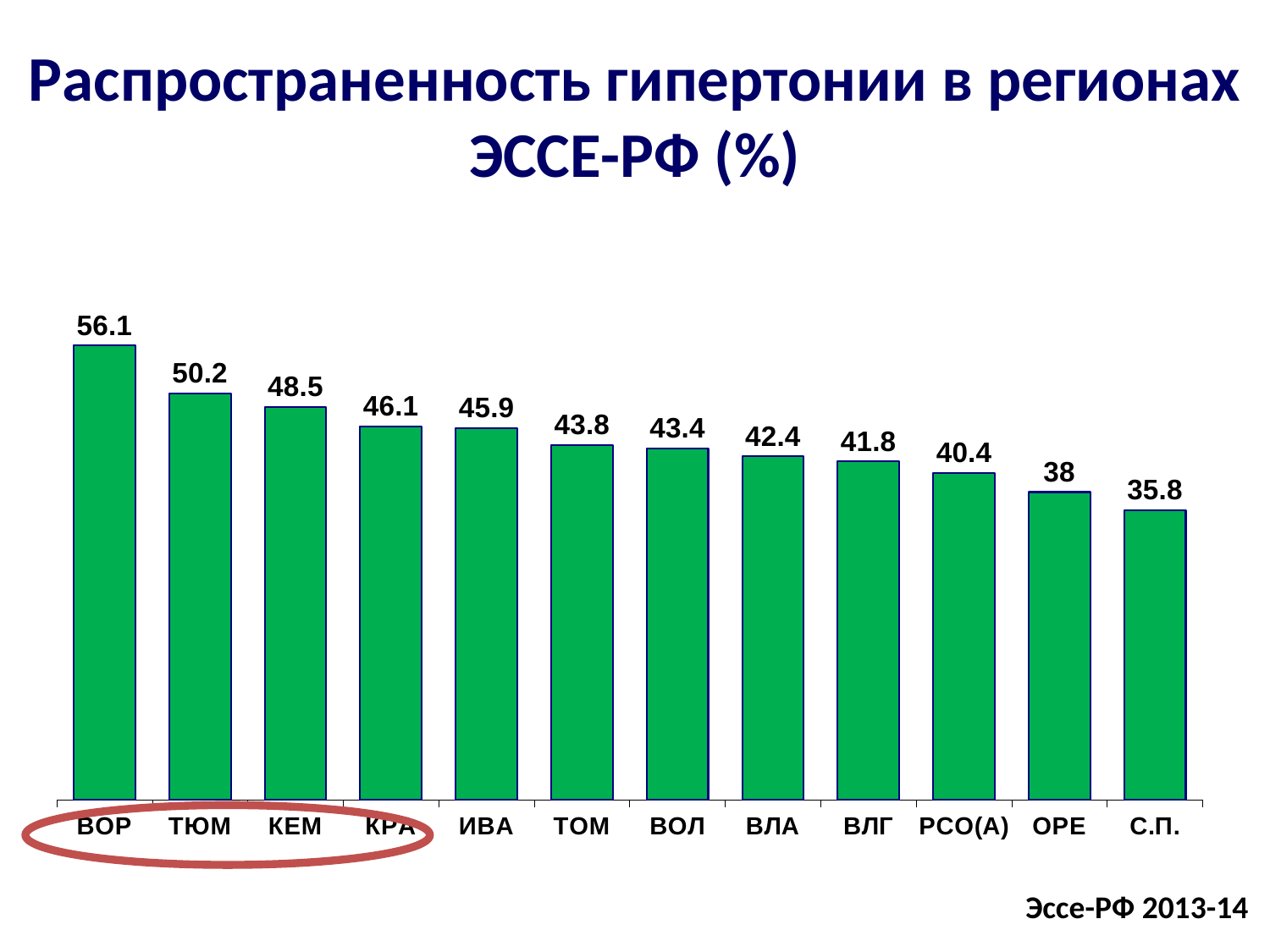
What is the value for С.П.? 35.8 Which region has the lowest value? С.П. Do the values rise or fall from left to right along the x axis? fall What is the value for ВОР? 56.1 How many regions are shown on the chart? 12 What is the difference between the values for ТЮМ and КЕМ? 1.7 What kind of chart is shown on the slide? bar chart Which is larger, the value for ВЛГ or the value for РСО(А)? ВЛГ What is the value for ТЮМ? 50.2 What is the difference between the values for ВОР and С.П.? 20.3 Which region has the highest value? ВОР What is the value for ОРЕ? 38